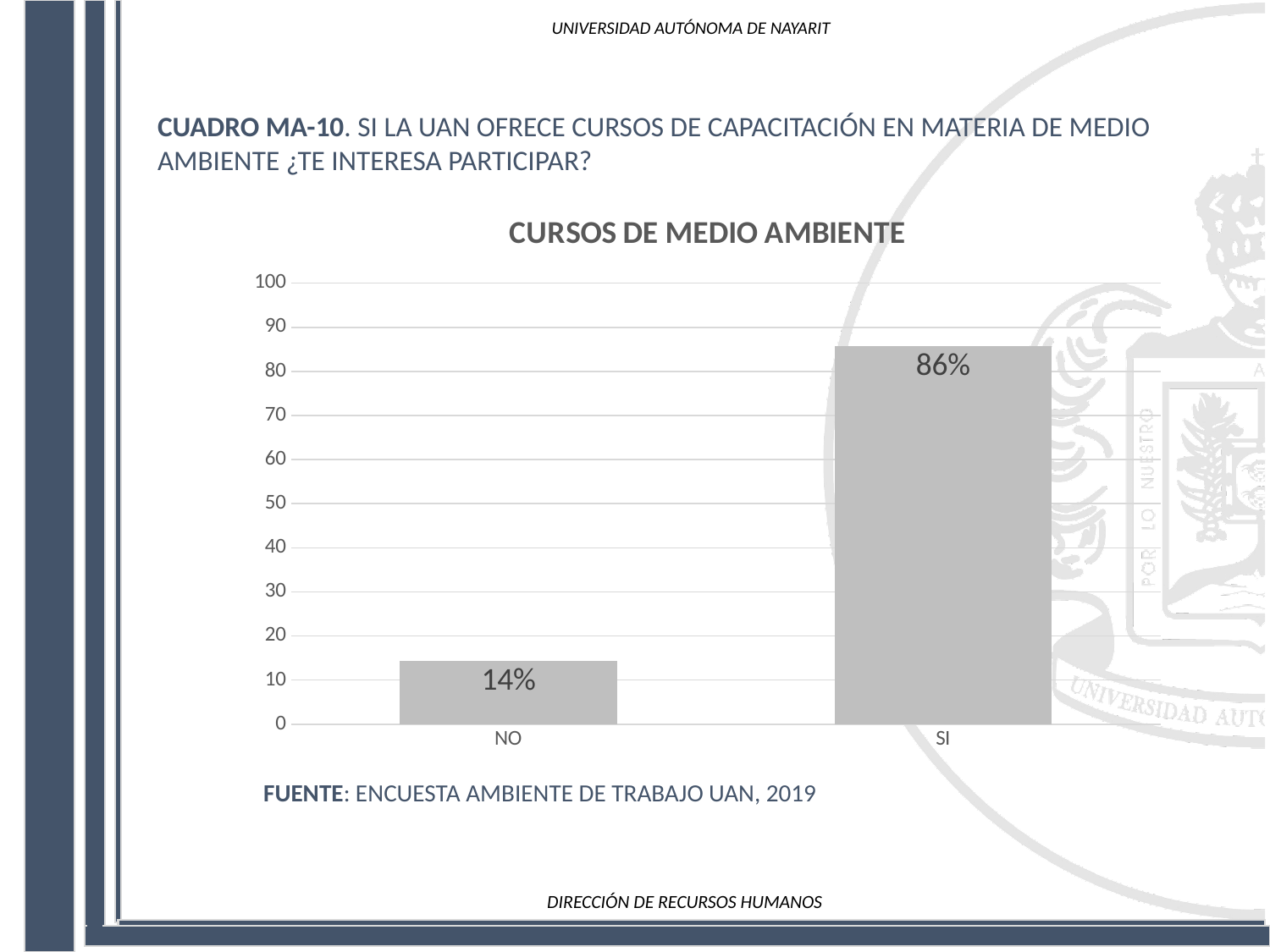
What is the title of the chart? CURSOS DE MEDIO AMBIENTE Which category has the lowest value in the chart? NO What is the value for SI in the CURSOS DE MEDIO AMBIENTE chart? 86% What is the maximum value shown on the vertical axis of the chart? 100 Is the value for SI greater or less than 80? greater Is the value for NO greater or less than 20? less Which is larger, the value for NO or the value for SI? SI How many categories are shown on the x axis of the chart? 2 What is the difference between the values for SI and NO? 72% What kind of chart is shown on the slide? bar chart What is the value for NO in the CURSOS DE MEDIO AMBIENTE chart? 14% Which category has the highest value in the chart? SI